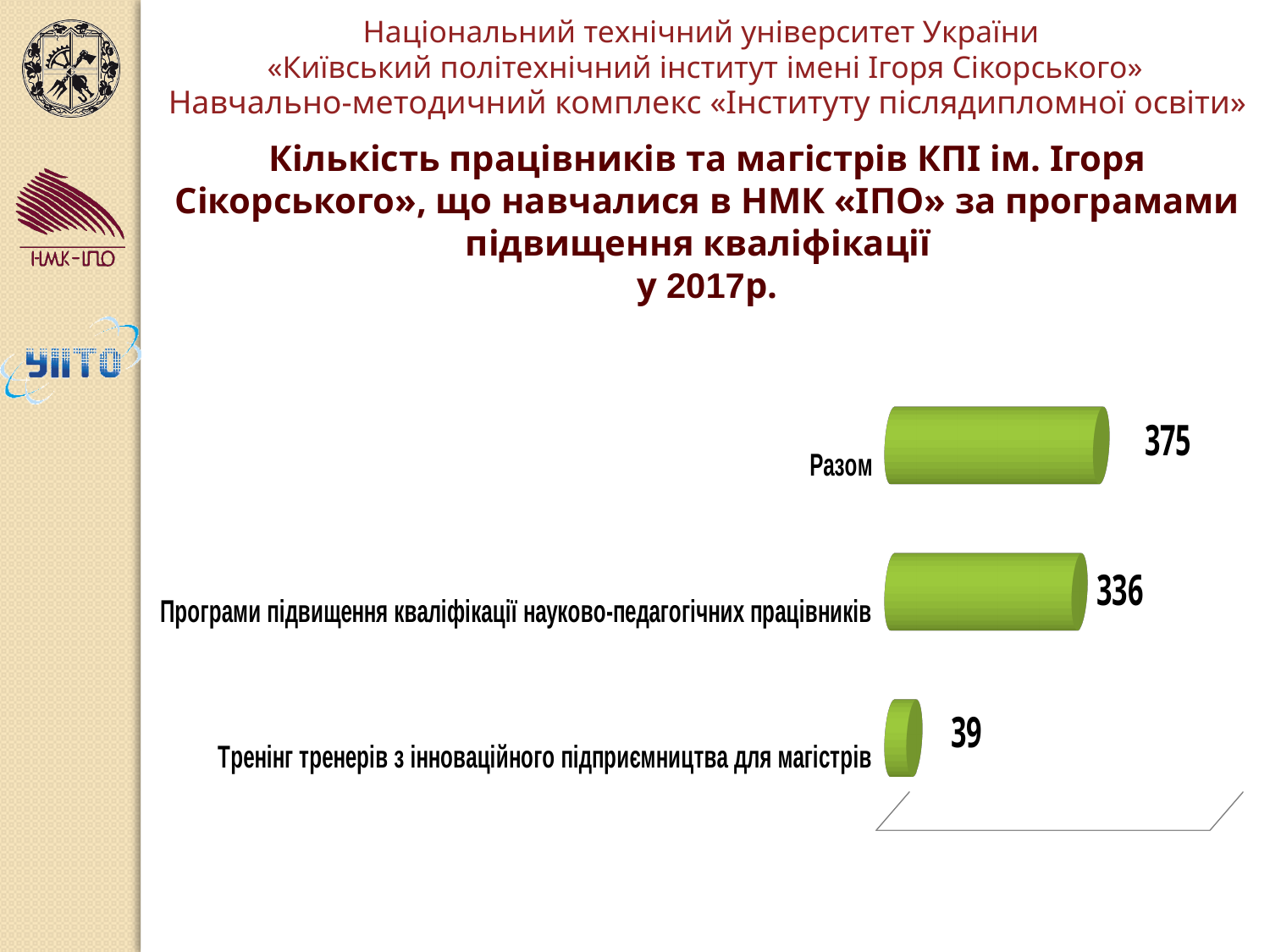
What is the value for "Тренінг тренерів з інноваційного підприємництва для магістрів"? 39 What is the difference between the values for "Разом" and "Програми підвищення кваліфікації науково-педагогічних працівників"? 39 Which category has the lowest value? Тренінг тренерів з інноваційного підприємництва для магістрів What is the difference between the values for "Програми підвищення кваліфікації науково-педагогічних працівників" and "Тренінг тренерів з інноваційного підприємництва для магістрів"? 297 What kind of chart is shown on the slide? Bar chart What year does the chart title say the data is for? 2017 What is the value for "Разом"? 375 What is the value for "Програми підвищення кваліфікації науково-педагогічних працівників"? 336 How many categories are shown in the chart? 3 Which is larger: the value for "Програми підвищення кваліфікації науково-педагогічних працівників" or the value for "Тренінг тренерів з інноваційного підприємництва для магістрів"? Програми підвищення кваліфікації науково-педагогічних працівників What colour are the bars in the chart? Green Which category has the highest value? Разом